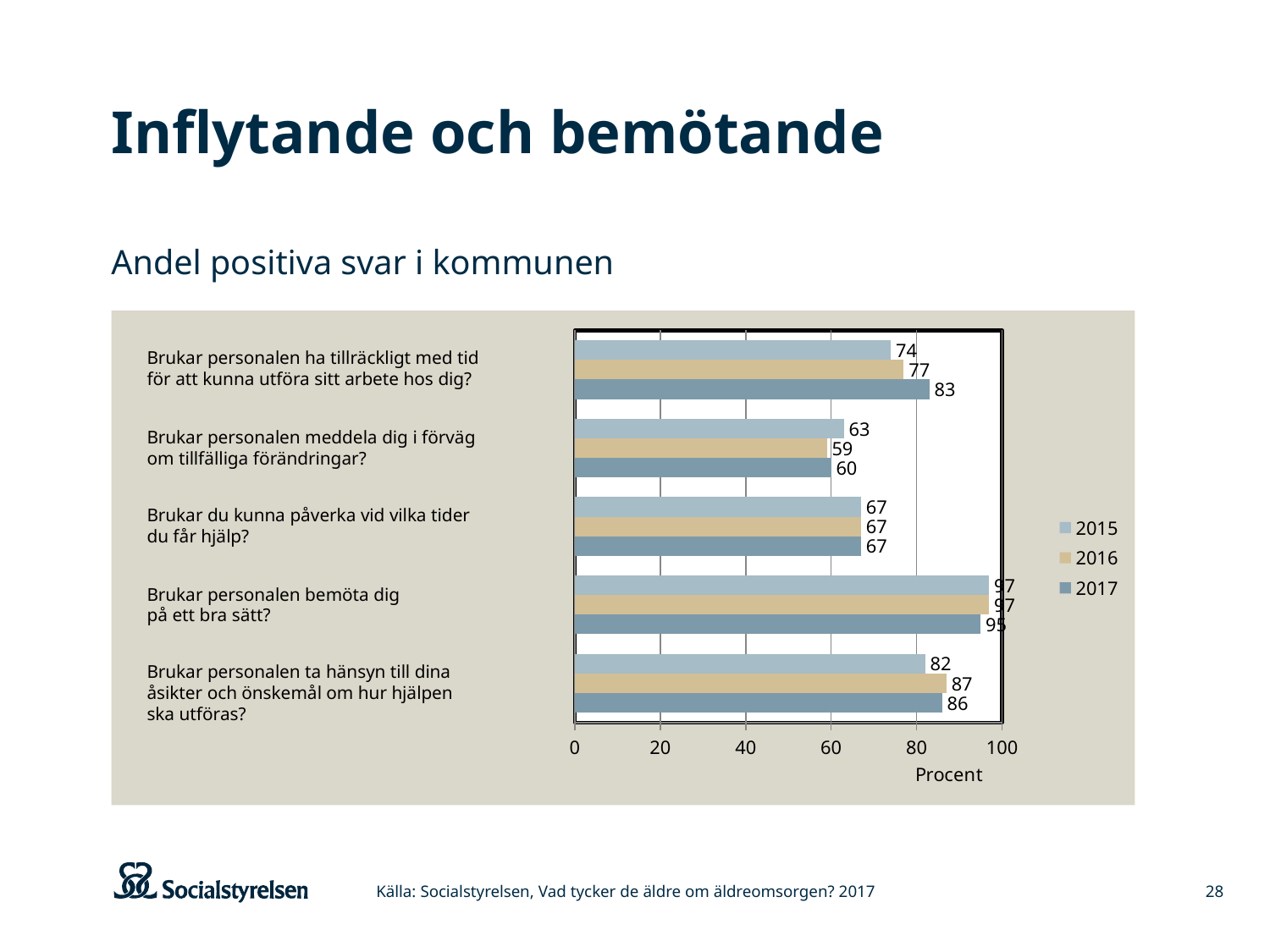
What kind of chart is shown on the slide? bar chart What is the difference between the 2017 and 2015 values for 'Brukar personalen ha tillräckligt med tid för att kunna utföra sitt arbete hos dig?'? 9 Which question category has the highest values across all three years? Brukar personalen bemöta dig på ett bra sätt? For 'Brukar personalen ta hänsyn till dina åsikter och önskemål om hur hjälpen ska utföras?', which is larger: the 2016 value or the 2015 value? 2016 What is the 2017 value for 'Brukar personalen ha tillräckligt med tid för att kunna utföra sitt arbete hos dig?'? 83 How many question categories are plotted on the chart? 5 What is the 2015 value for 'Brukar personalen ta hänsyn till dina åsikter och önskemål om hur hjälpen ska utföras?'? 82 What is the 2016 value for 'Brukar personalen meddela dig i förväg om tillfälliga förändringar?'? 59 Which year has the lowest value for 'Brukar personalen meddela dig i förväg om tillfälliga förändringar?'? 2016 Is the 2015 value for 'Brukar personalen bemöta dig på ett bra sätt?' greater or less than 80? greater What is the label on the horizontal axis of the chart? Procent How many series does the legend list? 3